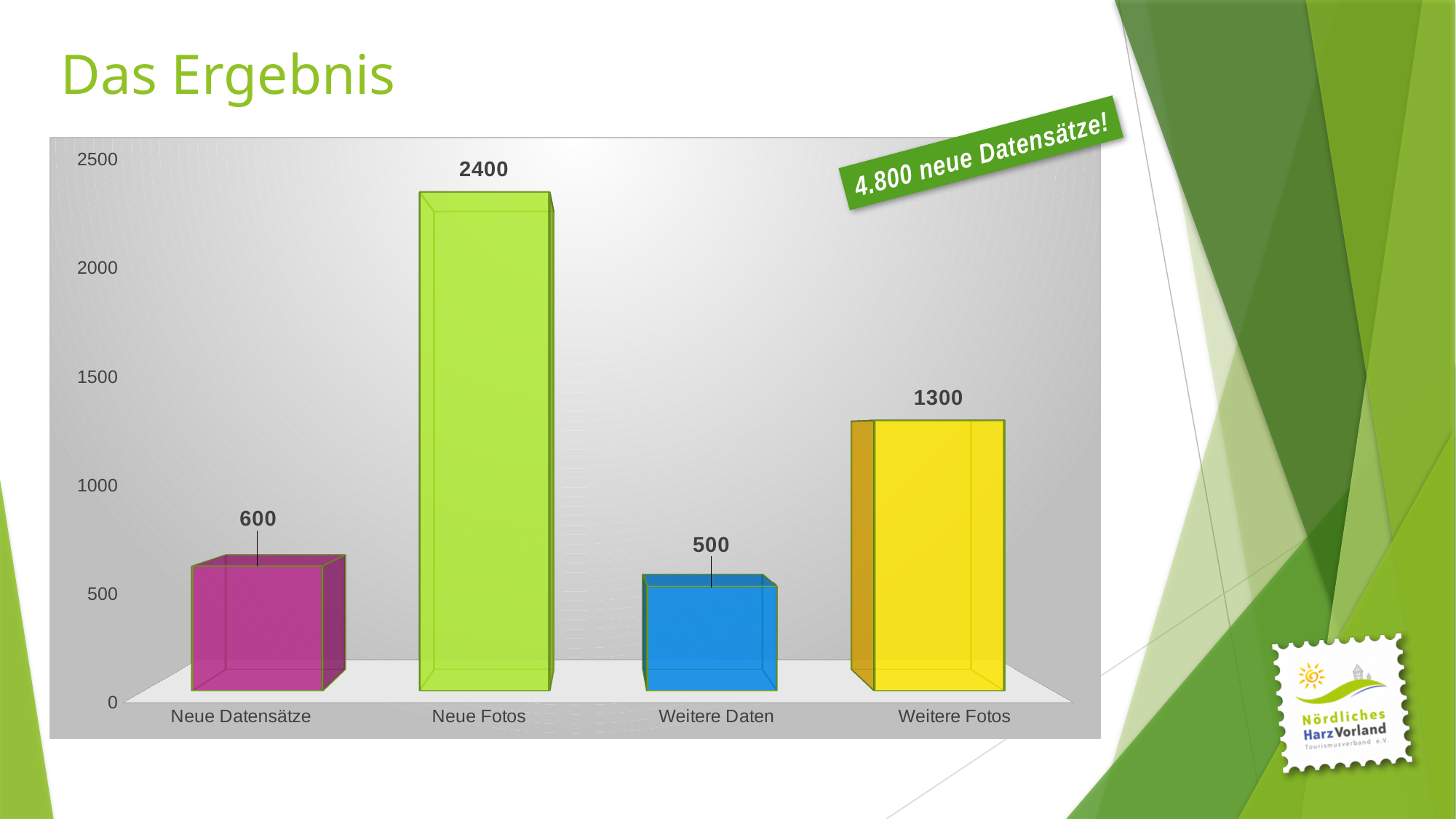
What is the value for Weitere Daten? 500 What kind of chart is shown on the slide? bar chart Which is larger, the value for Neue Datensätze or the value for Weitere Daten? Neue Datensätze How many categories are shown on the x axis? 4 Is the value for Weitere Fotos greater or less than 1000? greater What is the value for Neue Fotos? 2400 Which category has the highest value? Neue Fotos Which category has the lowest value? Weitere Daten What is the difference between the values for Neue Fotos and Weitere Fotos? 1100 What is the value for Neue Datensätze? 600 What is the title of the slide containing the chart? Das Ergebnis What is the value for Weitere Fotos? 1300